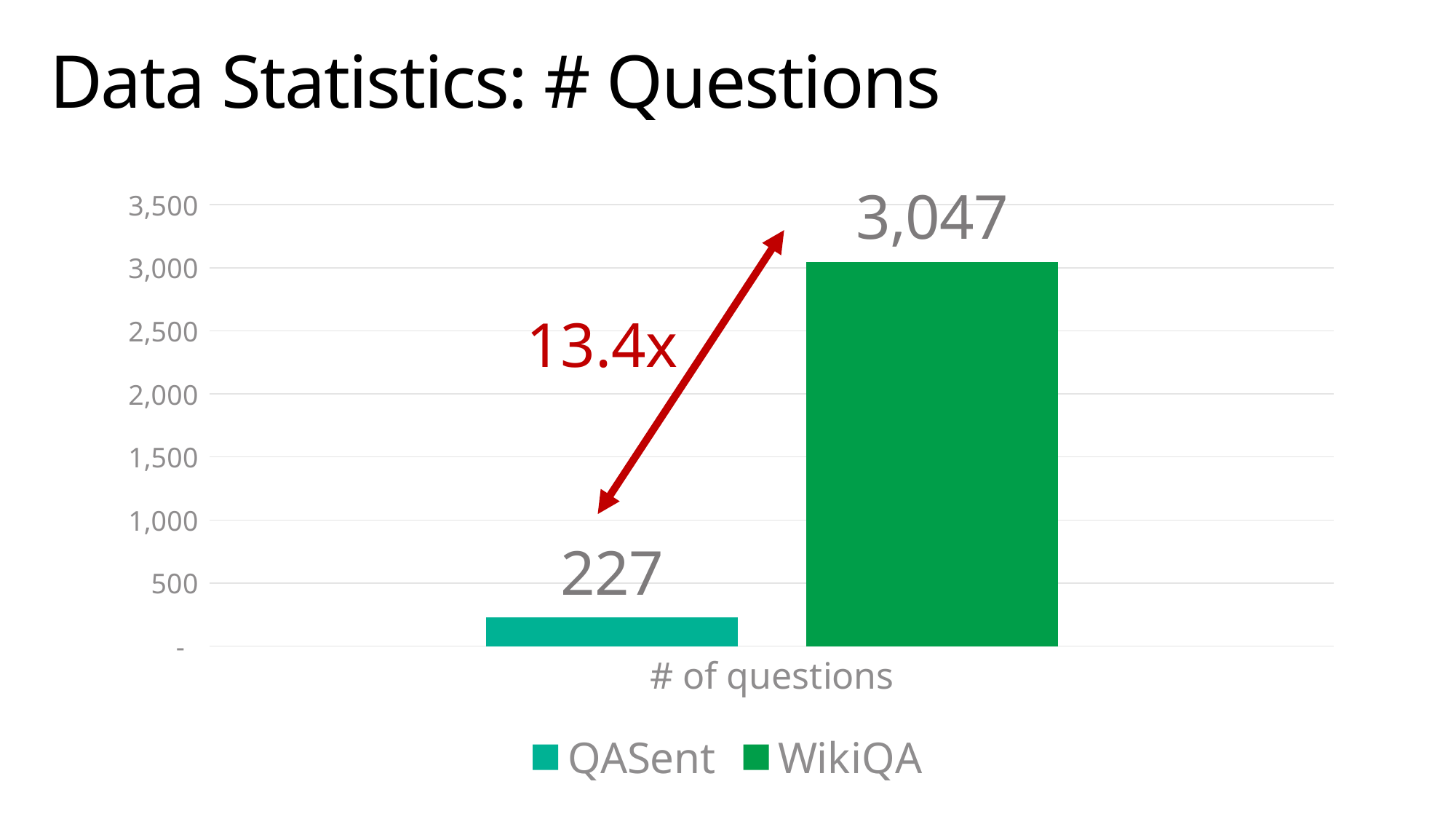
How many series does the legend list? 2 What kind of chart is shown on the slide? Bar chart What is the difference in the number of questions between WikiQA and QASent? 2,820 What is the title of the slide? Data Statistics: # Questions What is the number of questions for WikiQA? 3,047 What is the number of questions for QASent? 227 What multiplier is annotated in red between the two bars? 13.4x Is the value for WikiQA greater or less than 3,000? greater Is the number of questions for WikiQA larger than that for QASent? Yes Which series has the lower number of questions? QASent Is the value for QASent greater or less than 500? less Which series has the higher number of questions? WikiQA